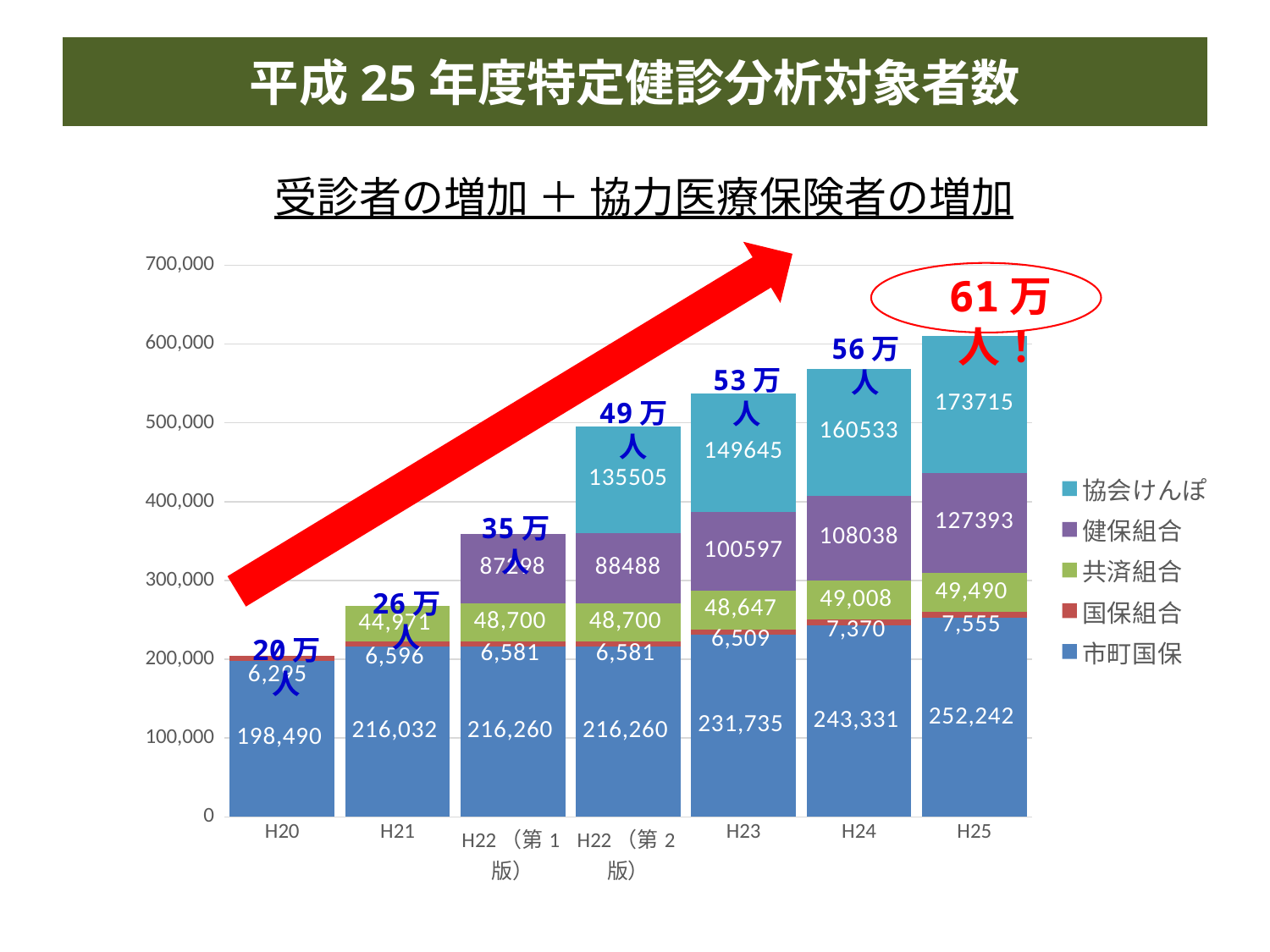
What is the value of 健保組合 for H24? 108038 What is the value of 市町国保 for H25? 252,242 What is the value of 国保組合 for H21? 6,596 How many series does the legend list? 5 Which category has the highest total bar? H25 What is the value of 協会けんぽ for H23? 149645 How many categories are shown on the x axis? 7 What is the value of 共済組合 for H22 (第2版)? 48,700 What is the difference between the 市町国保 values for H25 and H24? 8,911 Which category has the lowest total bar? H20 Is the total for H24 greater or less than 500,000? greater What type of chart is shown on the slide? stacked bar chart